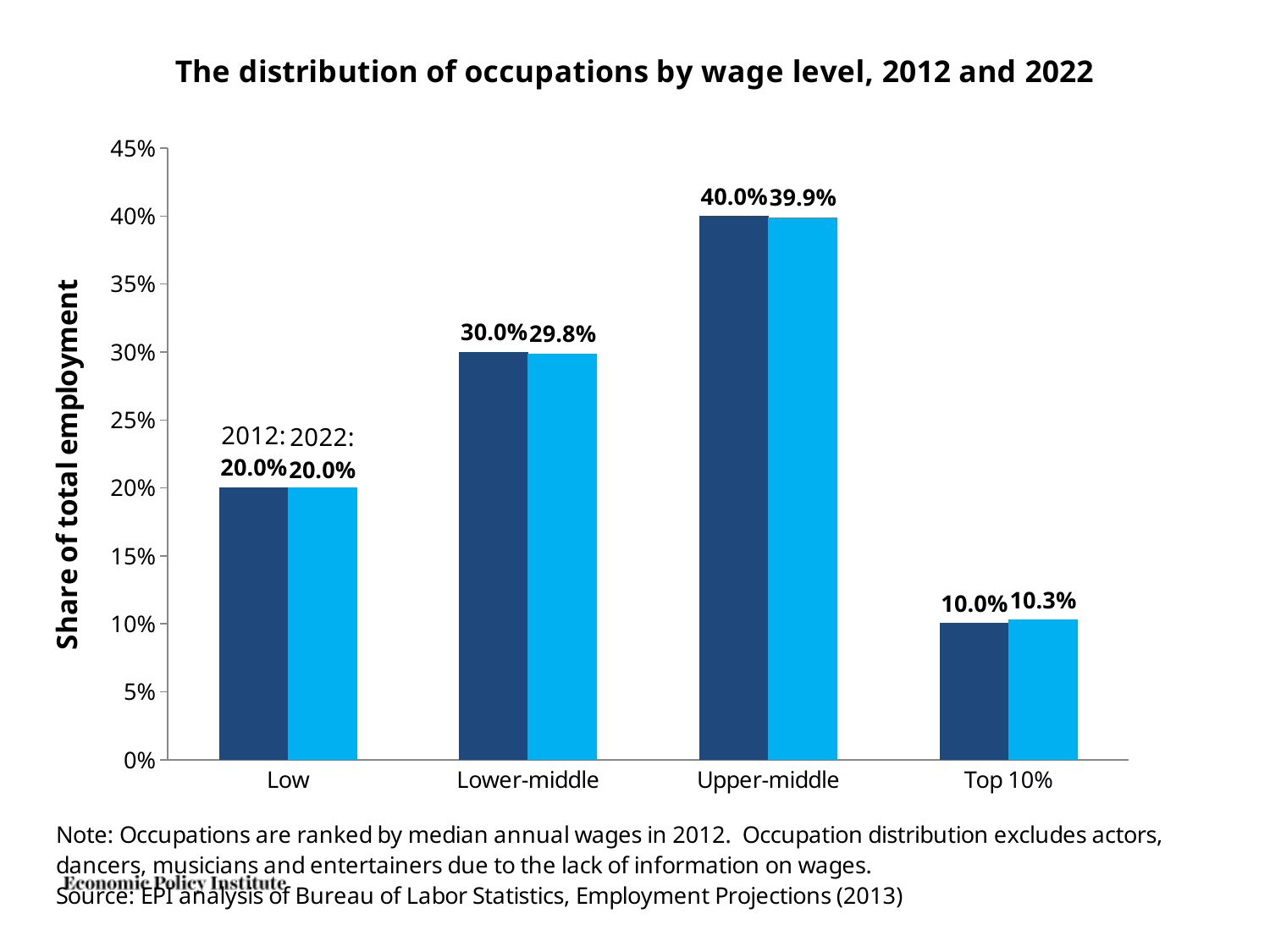
What is the difference between the 2012 shares for Lower-middle and Low wage occupations? 10.0% What is the 2012 share of total employment for Upper-middle wage occupations? 40.0% What kind of chart is shown on the slide? Bar chart How many years (series) are plotted for each category? 2 Which wage level category has the highest share of total employment in 2012? Upper-middle Which is larger for the Top 10% category: the 2012 share or the 2022 share? 2022 What is the 2012 share of total employment for Low wage occupations? 20.0% What is the 2022 share of total employment for the Top 10% category? 10.3% How many wage level categories are shown on the x axis? 4 Which wage level category has the lowest share of total employment in 2022? Top 10% What is the 2022 share of total employment for Lower-middle wage occupations? 29.8% What is the difference between the 2012 and 2022 shares for Upper-middle wage occupations? 0.1%